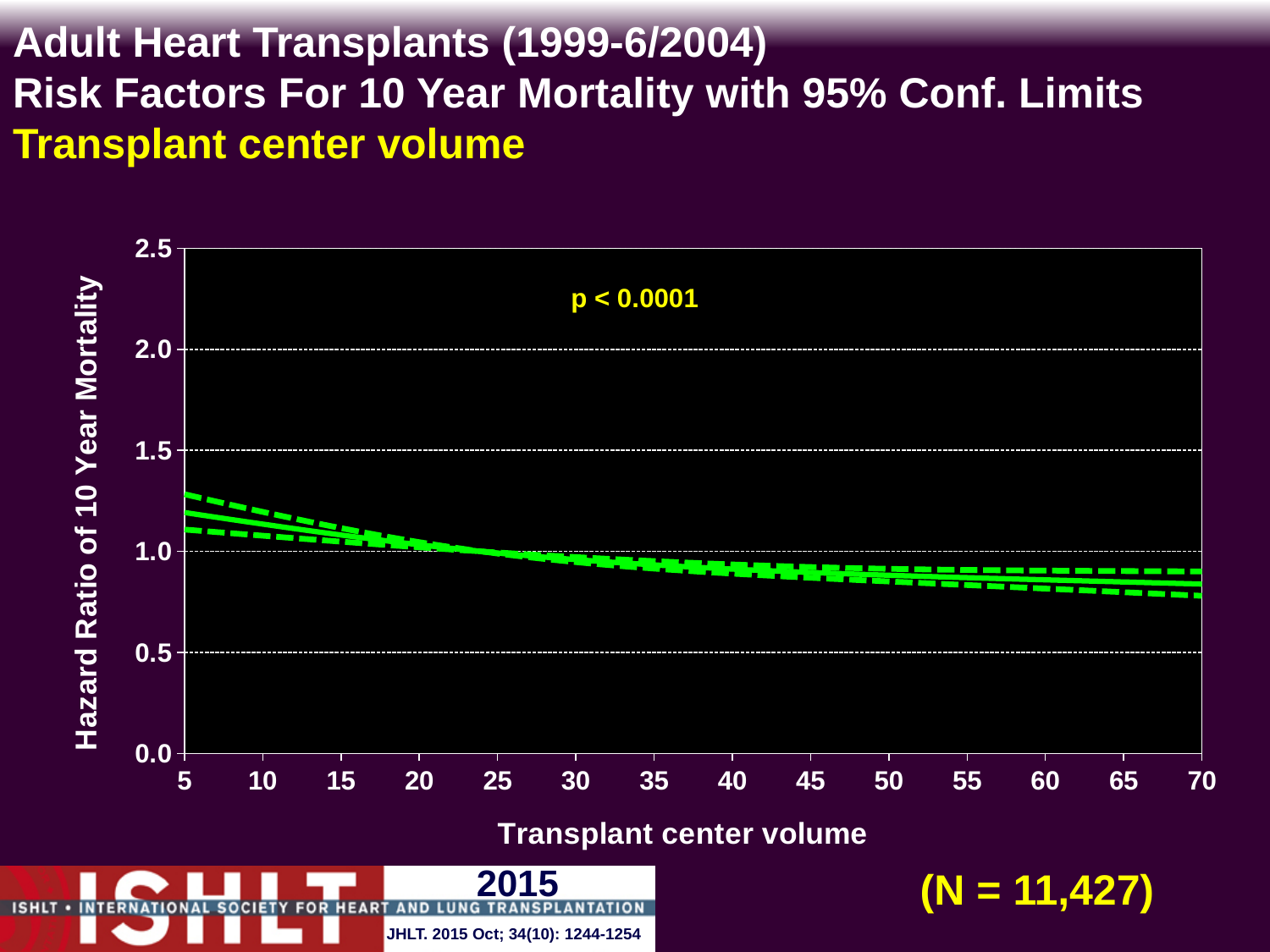
Is the hazard ratio at a transplant center volume of 70 greater or less than 1.0? less How many tick marks are labelled on the x axis? 14 Is the hazard ratio at a transplant center volume of 70 greater or less than 0.5? greater What p-value is printed on the chart? p < 0.0001 What is the highest value labelled on the y axis? 2.5 Does the hazard ratio rise or fall as transplant center volume increases along the x axis? fall Which has the higher hazard ratio: a transplant center volume of 10 or a volume of 60? 10 What kind of chart is shown on the slide? line chart Is the hazard ratio at a transplant center volume of 5 greater or less than 1.0? greater What is the lowest transplant center volume labelled on the x axis? 5 What is the label of the y axis? Hazard Ratio of 10 Year Mortality